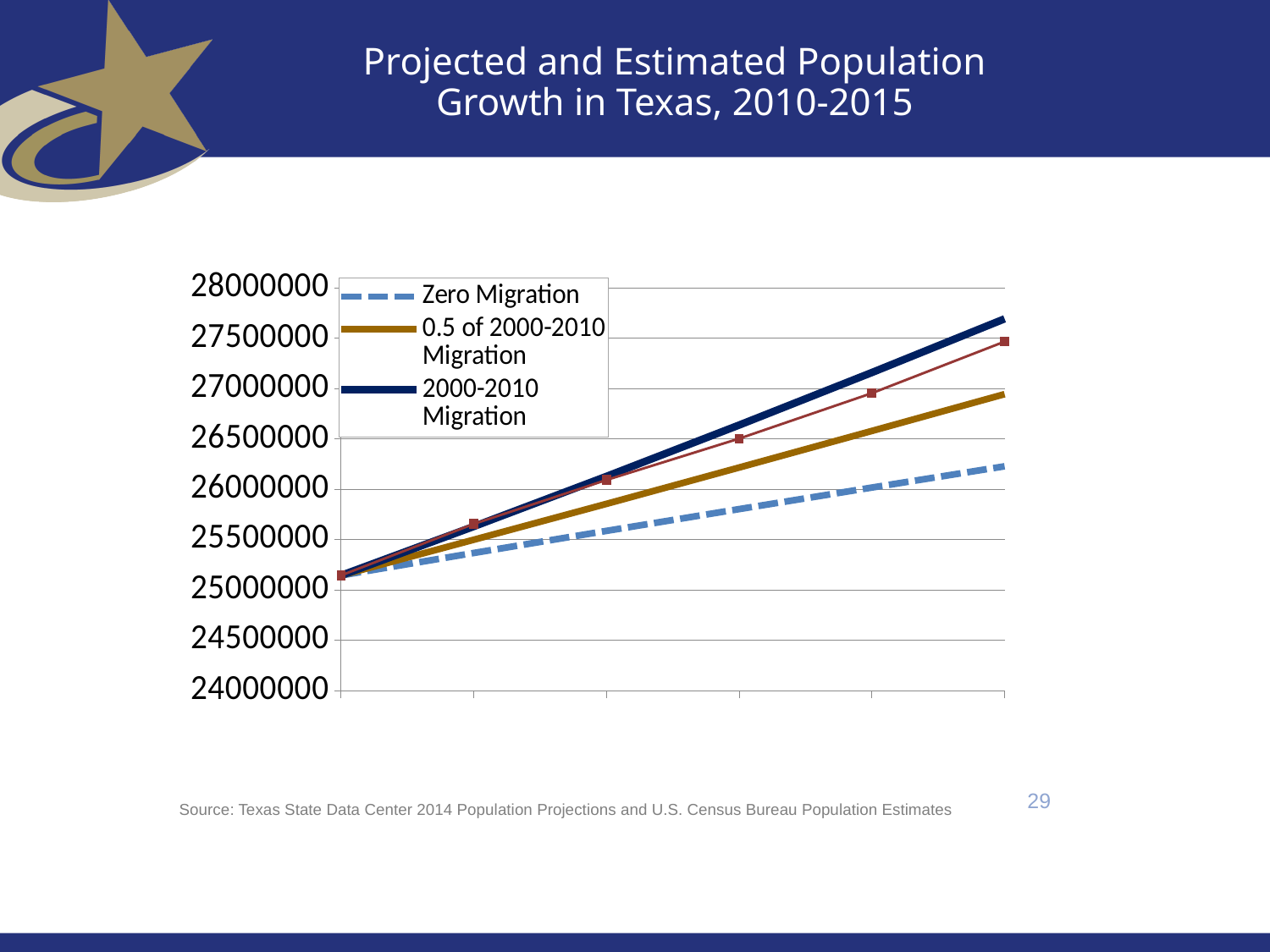
At the right end of the chart, is the value of the Zero Migration series greater or less than 26500000? less At the right end of the chart, is the value of the 0.5 of 2000-2010 Migration series greater or less than 27500000? less Which legend series has the lowest value at the right end of the chart? Zero Migration At the right end of the chart, is the value of the 2000-2010 Migration series greater or less than 27500000? greater At the right end of the chart, which is larger: the 0.5 of 2000-2010 Migration value or the Zero Migration value? 0.5 of 2000-2010 Migration Do the values of the 2000-2010 Migration series rise or fall from left to right? Rise What kind of chart is shown on the slide? Line chart How many series does the chart's legend list? 3 Do the values of the Zero Migration series rise or fall from left to right? Rise What is the title of the chart on the slide? Projected and Estimated Population Growth in Texas, 2010-2015 Which legend series reaches the highest value at the right end of the chart? 2000-2010 Migration Which series in the legend is drawn with a dashed line? Zero Migration